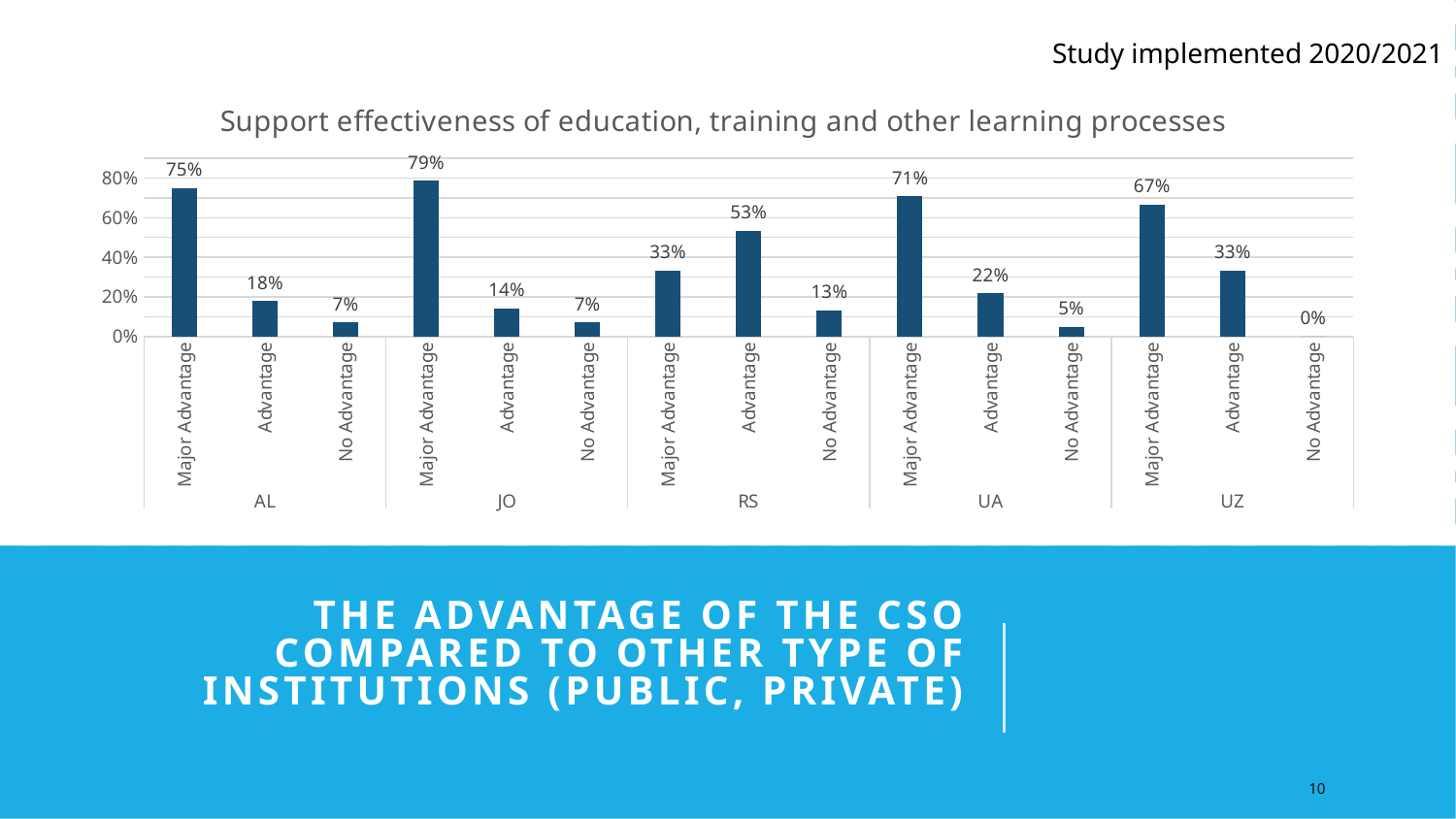
Is the value for Major Advantage in RS greater or less than 40%? less Which country has the lowest No Advantage value? UZ How many countries are shown on the x axis? 5 What is the value for Major Advantage in AL? 75% How many bars are plotted in the chart? 15 What is the title of the chart? Support effectiveness of education, training and other learning processes What is the difference between Major Advantage and Advantage in UZ? 34% What is the value for No Advantage in UA? 5% What is the value for Advantage in RS? 53% Which is larger, Advantage in UA or Advantage in JO? Advantage in UA Which country has the highest Major Advantage value? JO What kind of chart is this? bar chart